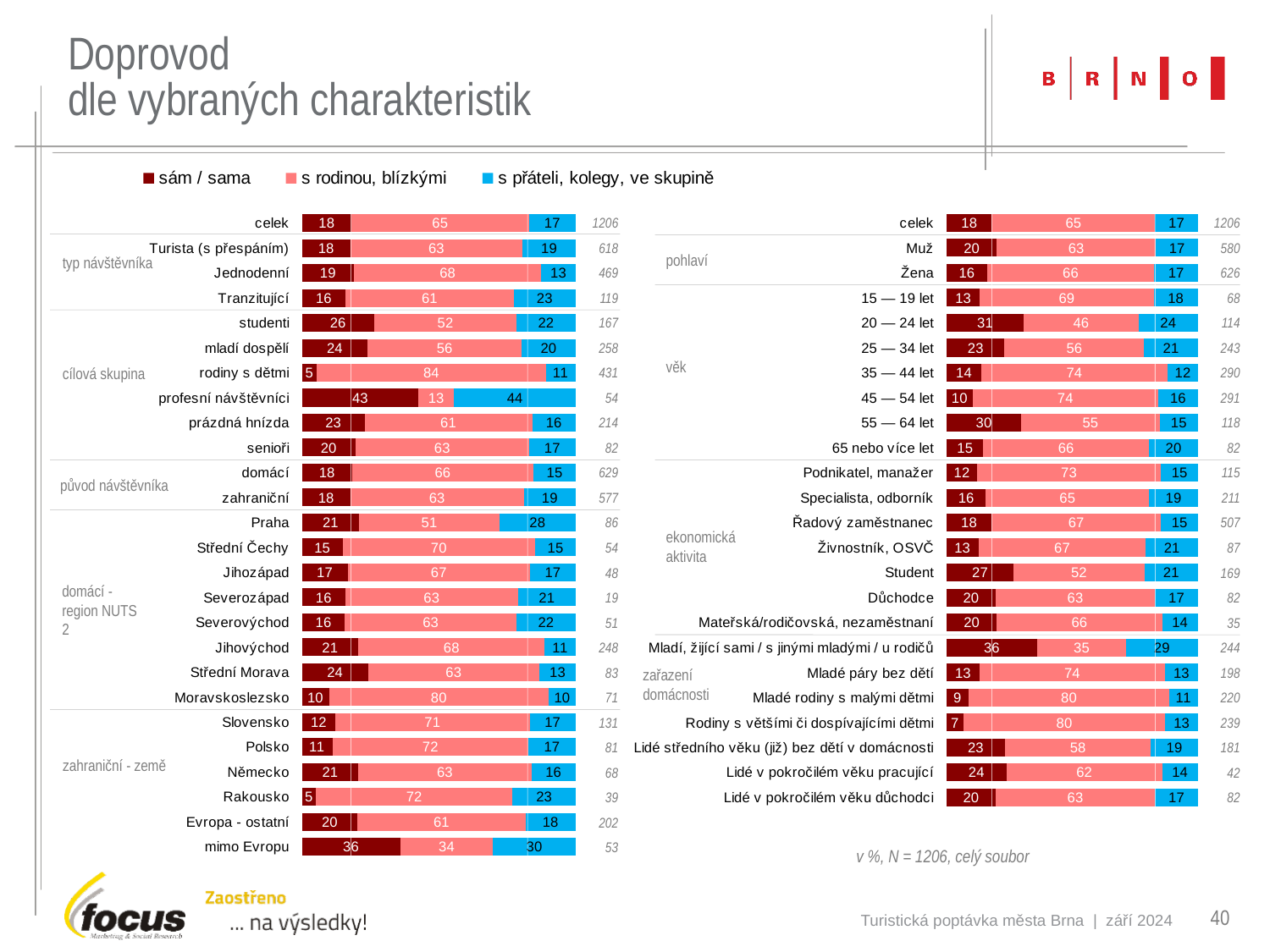
In the right chart, what is the value for 's přáteli, kolegy, ve skupině' for 'Mladí, žijící sami / s jinými mladými / u rodičů'? 29 In the left chart, what is the value for 'sám / sama' for 'mimo Evropu'? 36 In the right chart, what is the value for 'sám / sama' for '20 — 24 let'? 31 In the right chart, which has the larger 'sám / sama' value: 'Student' or 'Důchodce'? Student In the right chart, which category has the lowest value for 'sám / sama'? Rodiny s většími či dospívajícími dětmi In the left chart, what is the total of the stacked bar for 'celek'? 100 What kind of chart is shown on the slide? Stacked bar chart What are the three legend entries? sám / sama; s rodinou, blízkými; s přáteli, kolegy, ve skupině In the left chart, what is the difference between the 's přáteli, kolegy, ve skupině' values for 'Praha' and 'Moravskoslezsko'? 18 How many series does the legend list? 3 In the left chart, which category has the highest value for 's rodinou, blízkými'? rodiny s dětmi In the left chart, what is the value for 's rodinou, blízkými' for 'rodiny s dětmi'? 84